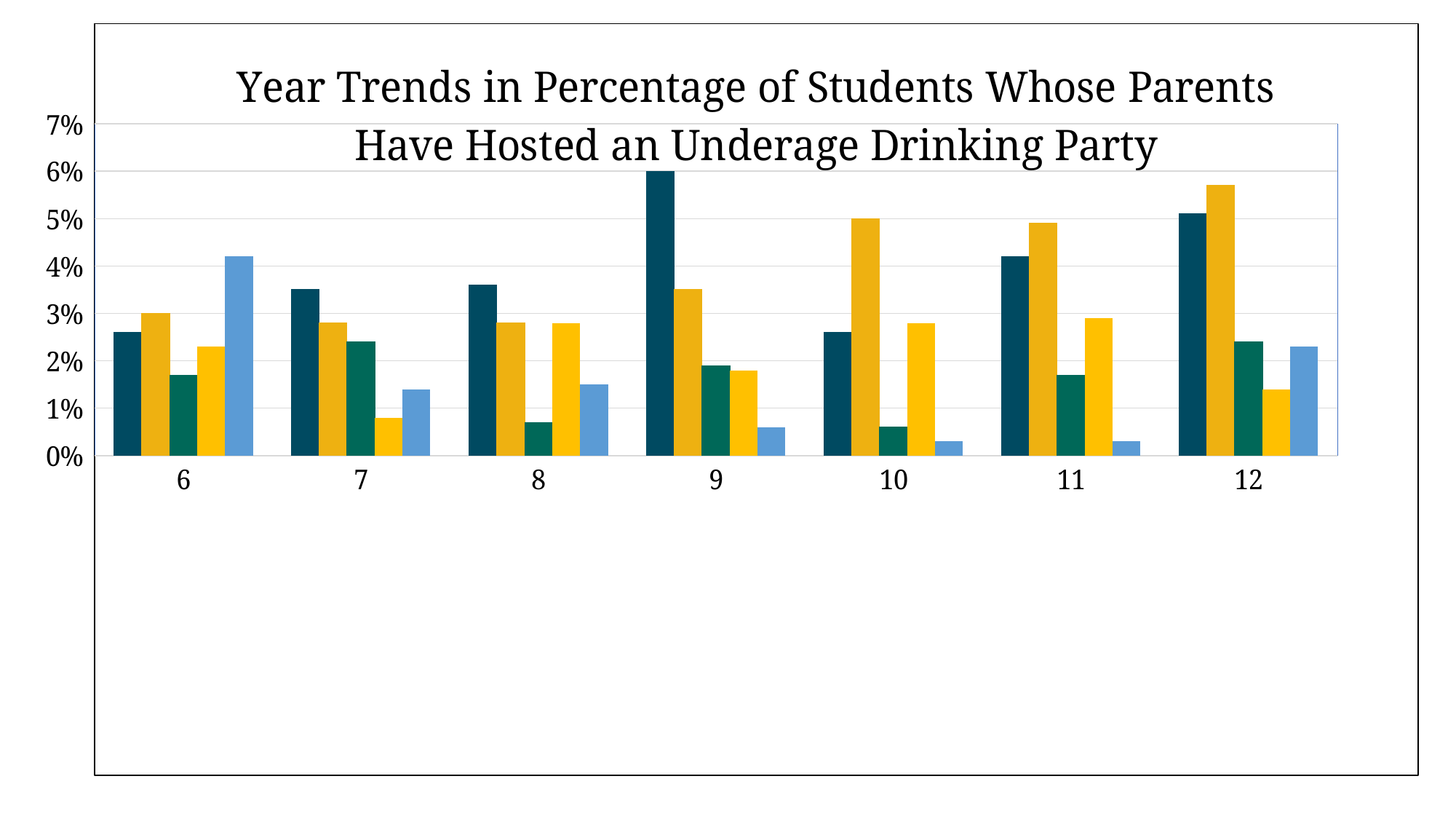
Is the dark navy bar for grade 9 greater or less than 5%? greater How many bars are plotted for each grade category? 5 Which grade has the tallest dark navy (first) bar? 9 Is the light blue bar for grade 10 greater or less than 1%? less What is the title of the chart? Year Trends in Percentage of Students Whose Parents Have Hosted an Underage Drinking Party Is the light blue bar for grade 6 greater or less than 3%? greater How many grade categories are shown along the x axis? 7 For grade 12, which is larger: the dark navy bar or the gold bar? the gold bar What kind of chart is shown on the slide? bar chart Which grade has the tallest bar in the whole chart? 9 Does the dark navy bar rise or fall from grade 6 to grade 9? rise